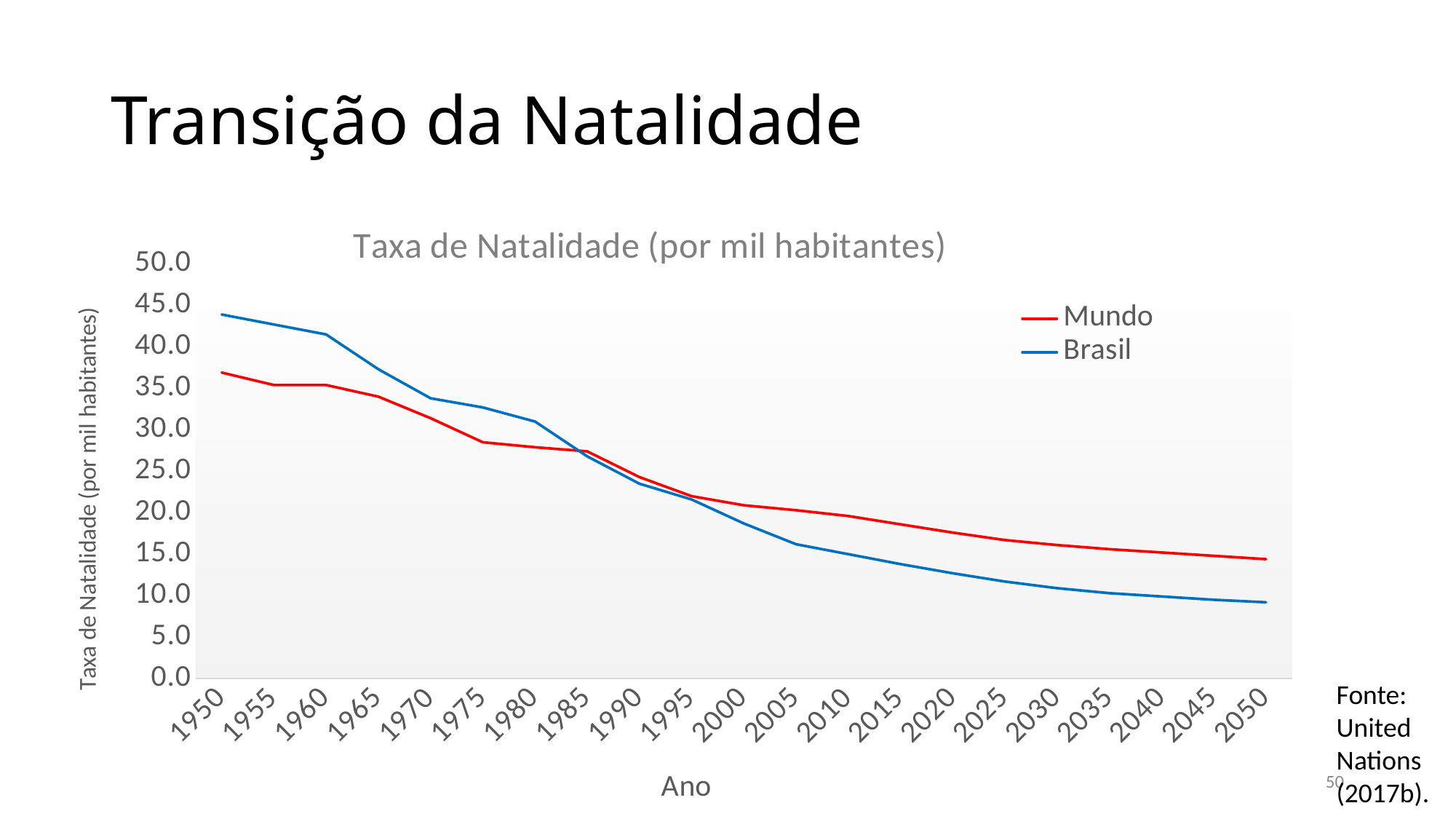
What kind of chart is shown on the slide? line chart What is the title of the chart? Taxa de Natalidade (por mil habitantes) How many years are labelled along the x axis? 21 How many series does the legend list? 2 Is the value for Mundo in 1975 greater or less than 30? less Which series has the higher value in 2050, Mundo or Brasil? Mundo Do the values for Brasil rise or fall from 1950 to 2050? fall Which series has the higher value in 1950, Mundo or Brasil? Brasil Is the value for Brasil in 1950 greater or less than 40? greater Is the value for Brasil in 2050 greater or less than 10? less Do the values for Mundo rise or fall from 1950 to 2050? fall